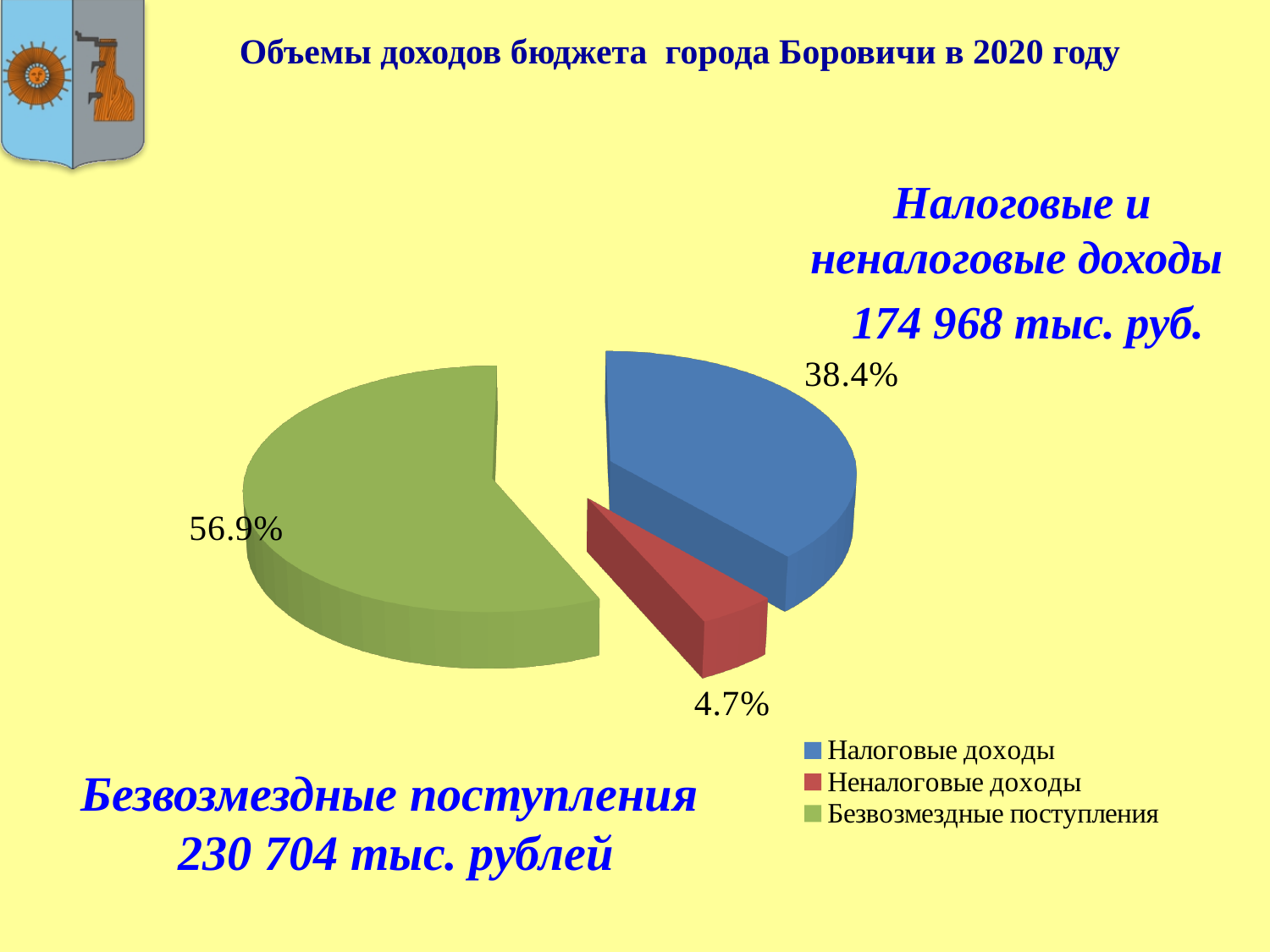
What is the difference in percentage points between Безвозмездные поступления and Налоговые доходы? 18.5 How many entries does the legend list? 3 What colour is the slice for Безвозмездные поступления? Green What is the title of the slide containing the chart? Объемы доходов бюджета города Боровичи в 2020 году Which category has the largest slice of the pie? Безвозмездные поступления Which category has the smallest slice of the pie? Неналоговые доходы Which is larger, the share for Налоговые доходы or the share for Неналоговые доходы? Налоговые доходы What share of the pie does Налоговые доходы have? 38.4% What share of the pie does Безвозмездные поступления have? 56.9% How many slices does the pie chart have? 3 What share of the pie does Неналоговые доходы have? 4.7% What kind of chart is shown on the slide? Pie chart